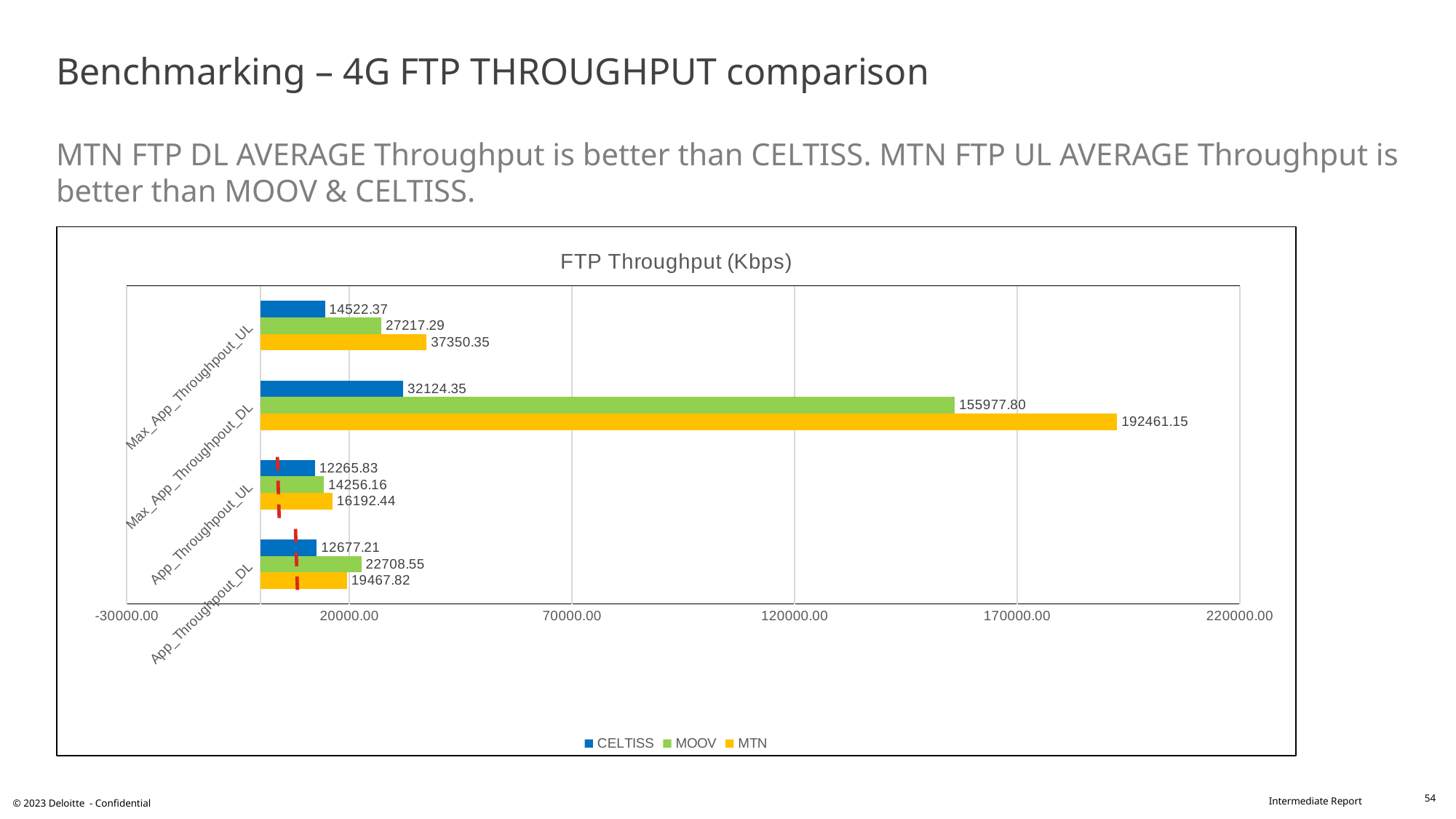
What is the MOOV value for App_Throughpout_DL? 22708.55 Which operator has the highest value for Max_App_Throughpout_DL? MTN What is the CELTISS value for App_Throughpout_UL? 12265.83 How many series does the legend list? 3 What is the MTN value for Max_App_Throughpout_DL? 192461.15 For App_Throughpout_DL, which is larger: the MOOV value or the MTN value? MOOV What is the difference between the MTN and MOOV values for Max_App_Throughpout_DL? 36483.35 What is the difference between the MOOV and MTN values for App_Throughpout_DL? 3240.73 Which operator has the lowest value for App_Throughpout_UL? CELTISS What is the MTN value for Max_App_Throughpout_UL? 37350.35 How many categories are shown on the chart? 4 What type of chart is shown on the slide? Bar chart